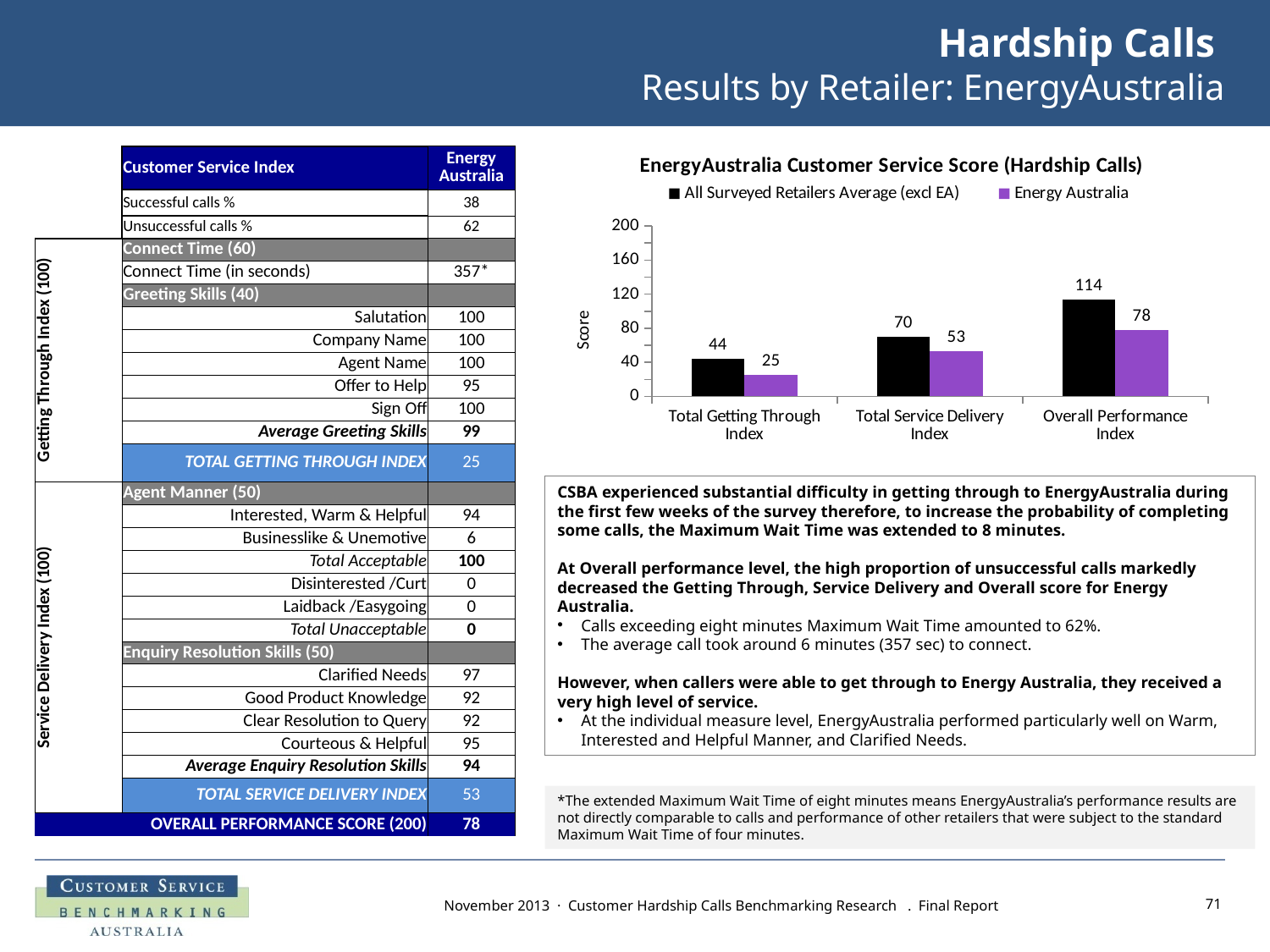
What is the title of the chart? EnergyAustralia Customer Service Score (Hardship Calls) Which category has the lowest Energy Australia value? Total Getting Through Index What is the Energy Australia value for the Total Service Delivery Index? 53 Which category has the highest All Surveyed Retailers Average (excl EA) value? Overall Performance Index What is the All Surveyed Retailers Average (excl EA) value for the Overall Performance Index? 114 For the Total Service Delivery Index, which series has the larger value: All Surveyed Retailers Average (excl EA) or Energy Australia? All Surveyed Retailers Average (excl EA) What kind of chart is shown on the slide? Bar chart What is the value for Energy Australia on the Total Getting Through Index? 25 What is the difference between the All Surveyed Retailers Average (excl EA) and Energy Australia values for the Total Getting Through Index? 19 What is the difference between the All Surveyed Retailers Average (excl EA) and Energy Australia values for the Overall Performance Index? 36 How many categories are shown on the x axis of the chart? 3 How many series does the chart legend list? 2